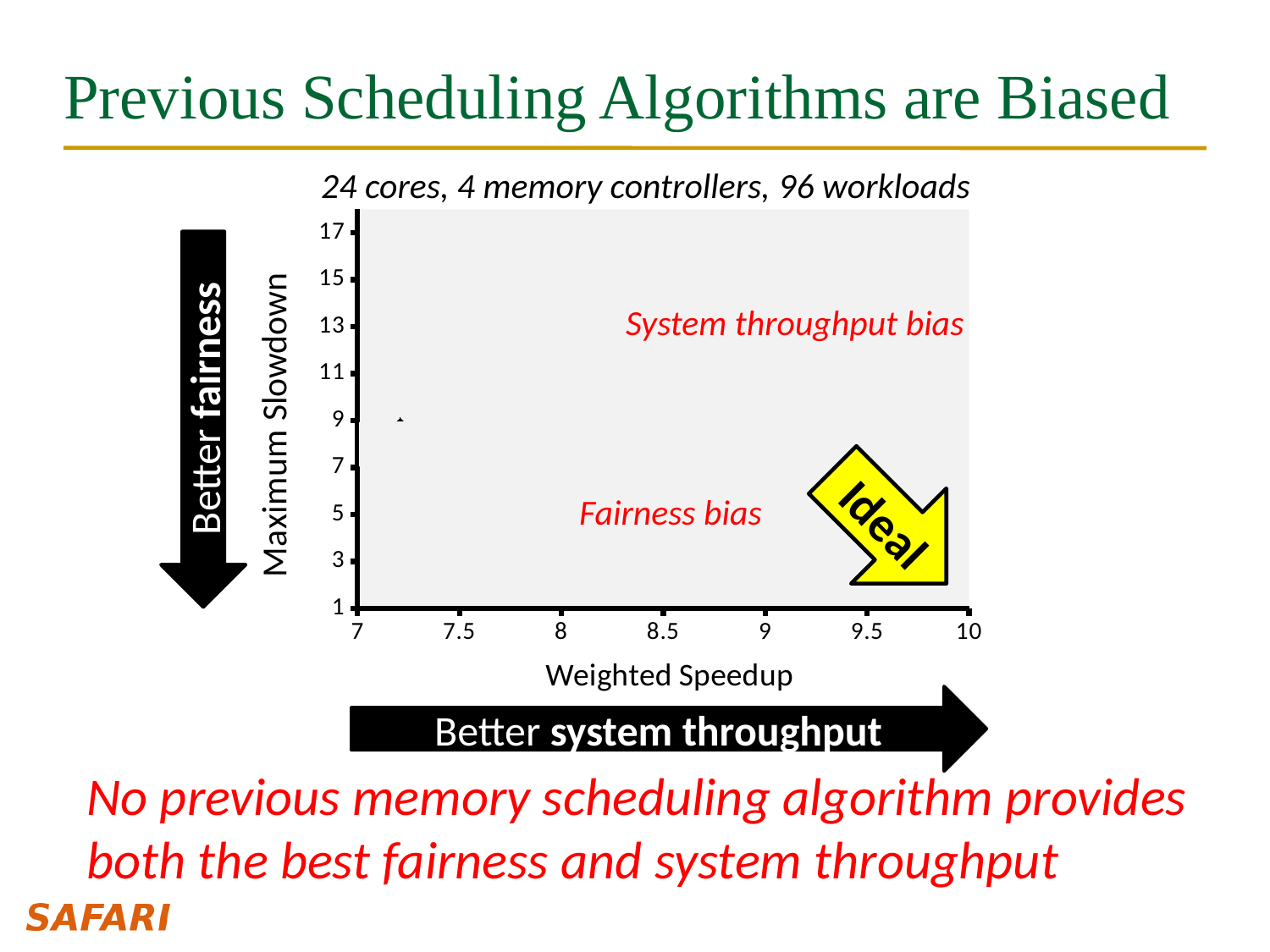
How many data points are plotted on the chart? 1 Is the Maximum Slowdown of the plotted point greater or less than 5? greater Is the Weighted Speedup of the plotted point greater or less than 9? less What is the highest value shown on the y axis of the chart? 17 What is the highest value shown on the x axis of the chart? 10 What is the label of the x axis of the chart? Weighted Speedup What is the title of the chart? 24 cores, 4 memory controllers, 96 workloads Is the Maximum Slowdown of the plotted point greater or less than 13? less What is the lowest value shown on the y axis of the chart? 1 What kind of chart is shown on the slide? scatter chart